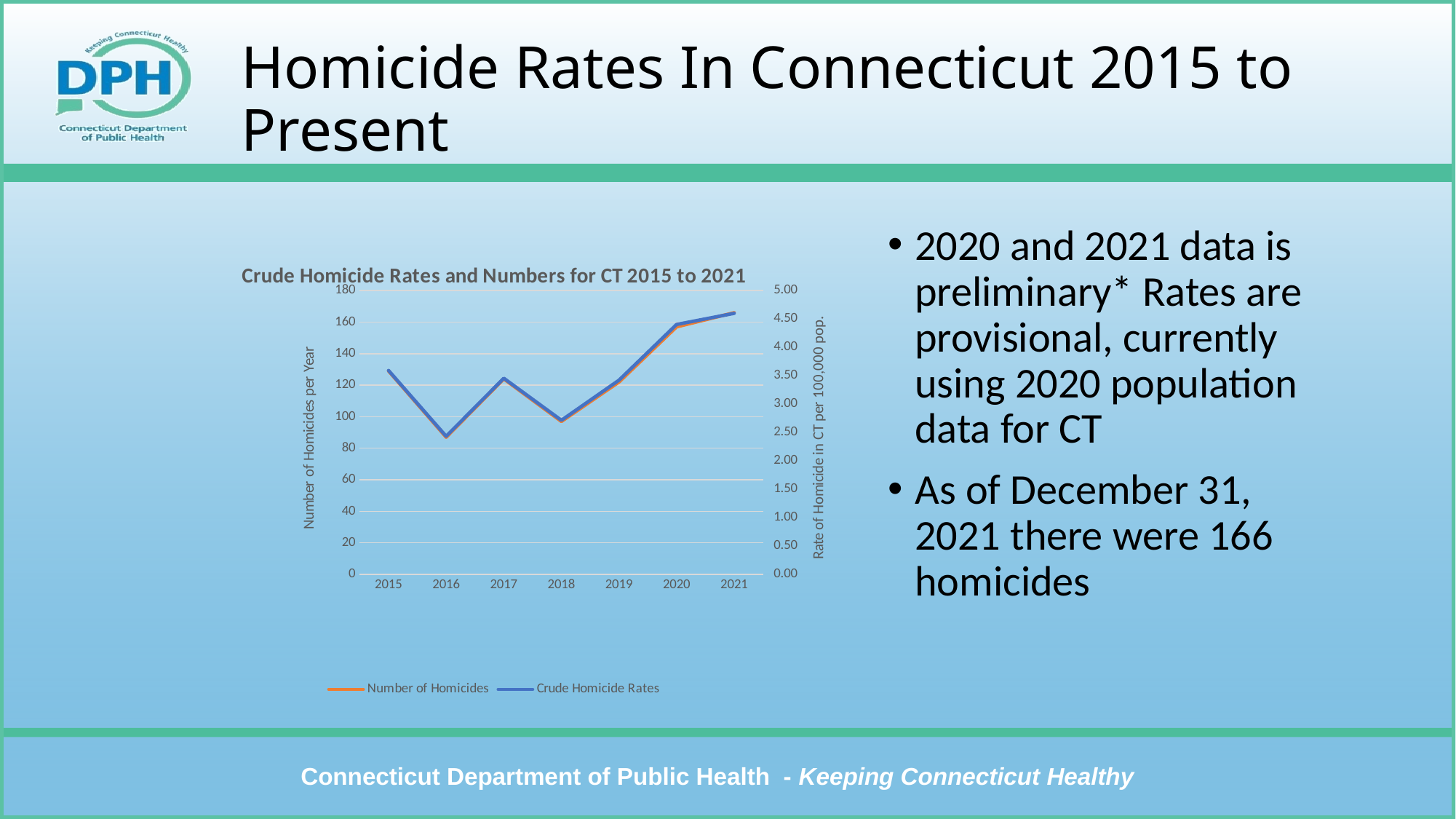
Do the values rise or fall from 2018 to 2021 in the chart? rise Is the number of homicides for 2016 greater or less than 100? less What is the title of the chart? Crude Homicide Rates and Numbers for CT 2015 to 2021 Which series in the chart is drawn in blue? Crude Homicide Rates What kind of chart is shown on the slide? line chart Is the number of homicides for 2021 greater or less than 160? greater How many years are plotted along the x axis of the chart? 7 Which year has the lowest number of homicides in the chart? 2016 How many series does the chart legend list? 2 Which year has the highest number of homicides in the chart? 2021 Which year has a higher number of homicides, 2020 or 2018? 2020 Is the number of homicides for 2020 greater or less than 140? greater